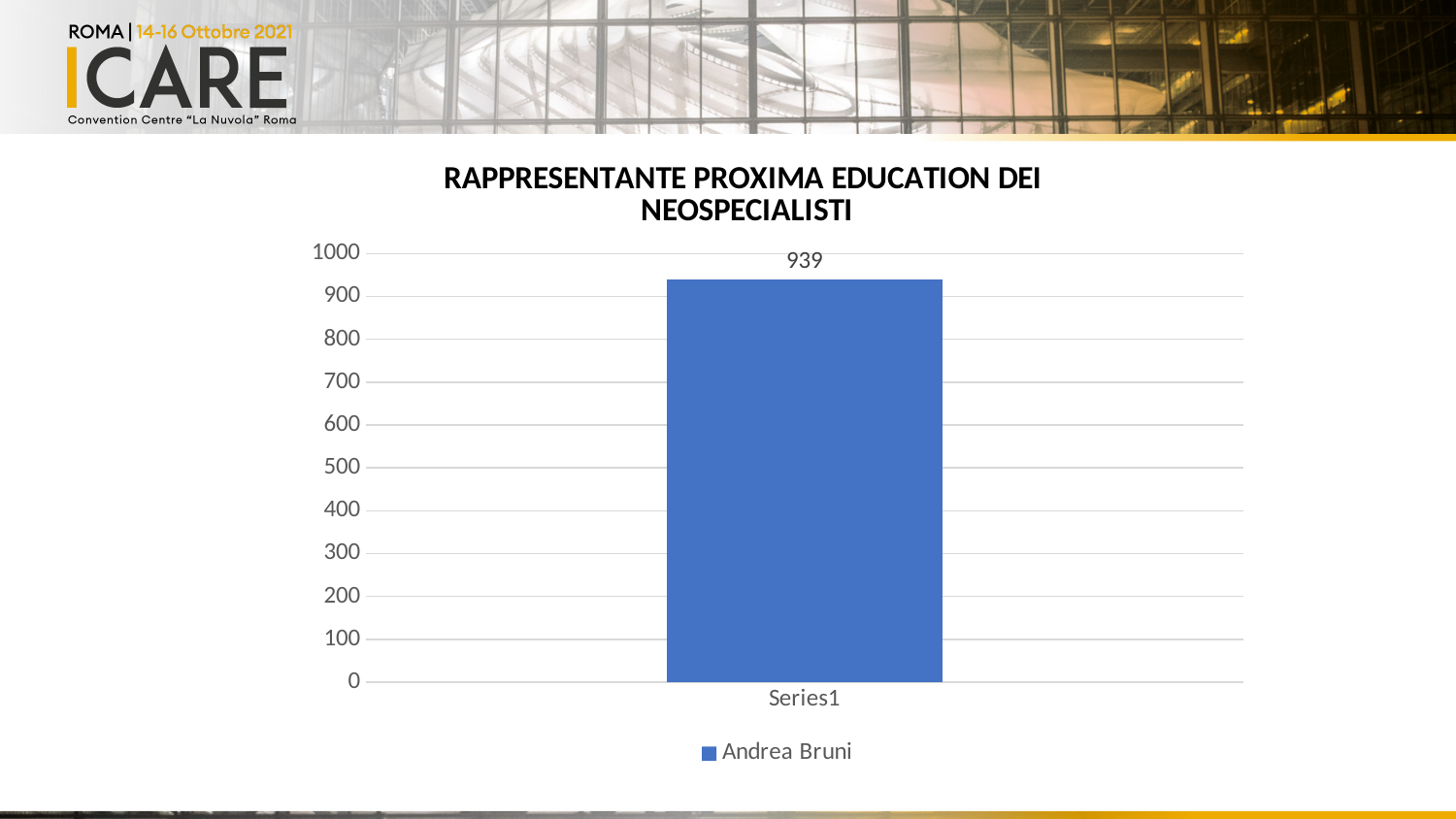
What is the title of the chart? RAPPRESENTANTE PROXIMA EDUCATION DEI NEOSPECIALISTI Is the value for Andrea Bruni greater or less than 1000? less What kind of chart is shown on the slide? bar chart What is the maximum value shown on the vertical axis? 1000 What is the category label shown under the bar on the x axis? Series1 Is the value for Andrea Bruni greater or less than 900? greater What is the value of the bar for Andrea Bruni? 939 How many bars are plotted in the chart? 1 How many series does the legend list? 1 What name appears in the chart legend? Andrea Bruni